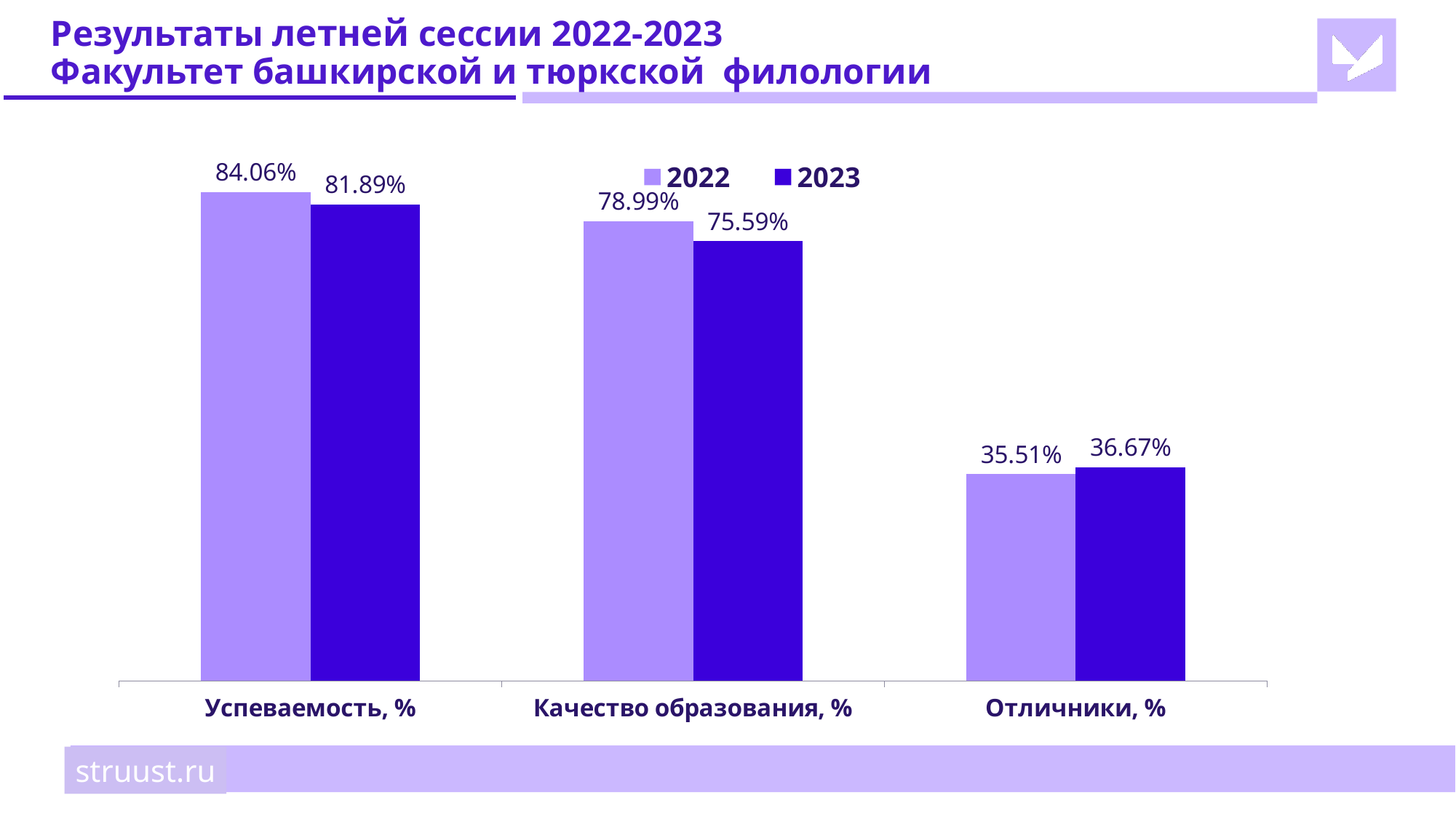
What is the difference between the 2022 and 2023 values for Успеваемость, %? 2.17% What is the difference between the 2022 and 2023 values for Качество образования, %? 3.40% Which category has the lowest 2023 value? Отличники, % How many series does the legend list? 2 What is the 2022 value for Успеваемость, %? 84.06% Which category has the highest 2022 value? Успеваемость, % What is the 2023 value for Отличники, %? 36.67% What is the 2023 value for Качество образования, %? 75.59% How many categories are shown on the x axis? 3 For Отличники, %, which year has the larger value, 2022 or 2023? 2023 What kind of chart is shown on the slide? Bar chart What is the 2022 value for Отличники, %? 35.51%